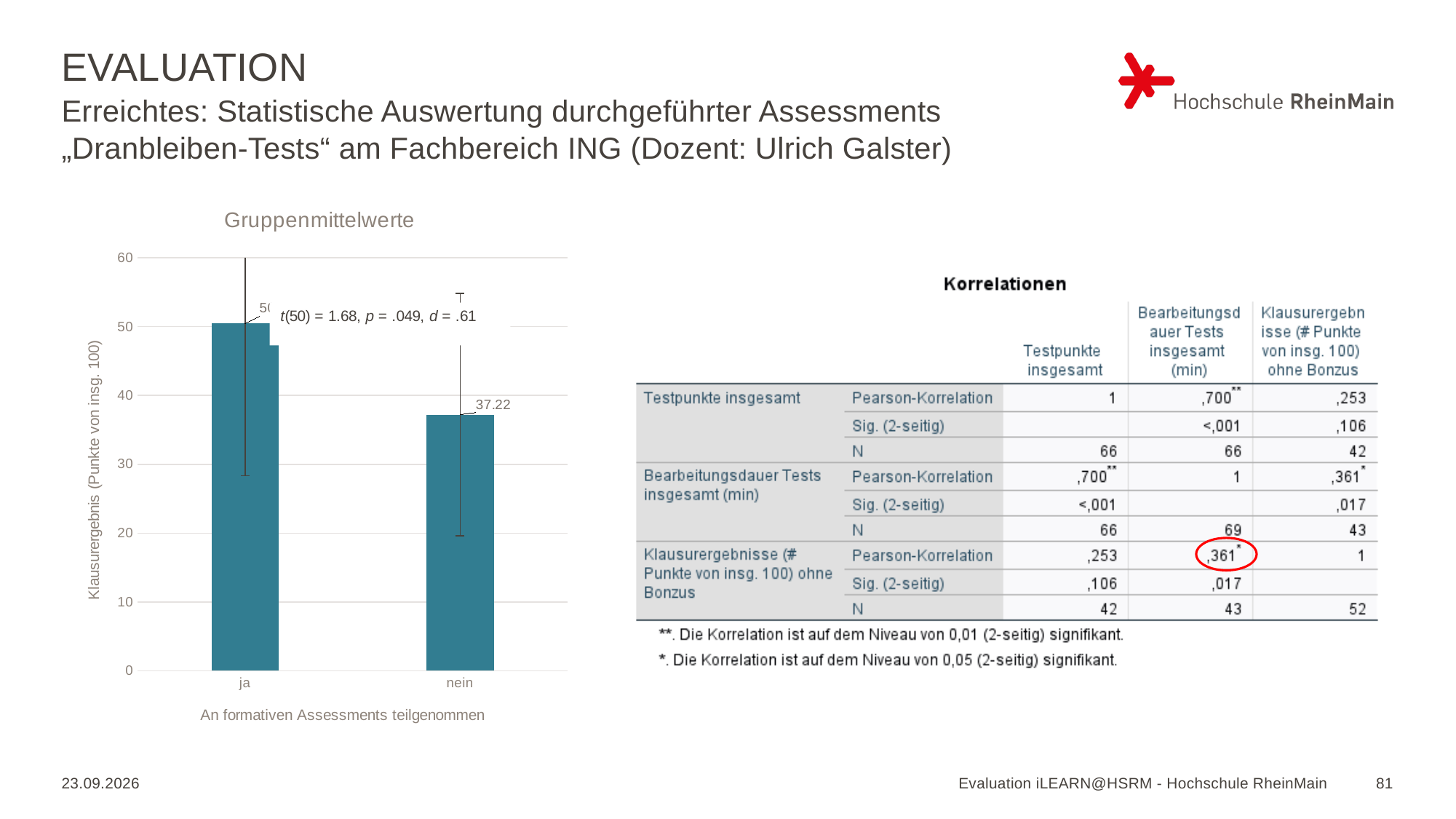
In the Gruppenmittelwerte chart, which category has the highest value? ja In the Gruppenmittelwerte chart, which is larger, the value for "ja" or the value for "nein"? ja What is the title of the bar chart on the slide? Gruppenmittelwerte In the Gruppenmittelwerte chart, is the value for "nein" greater or less than 30? greater In the Gruppenmittelwerte chart, is the value for "ja" greater or less than 40? greater What is the x-axis label of the Gruppenmittelwerte chart? An formativen Assessments teilgenommen How many categories are shown on the x axis of the Gruppenmittelwerte chart? 2 In the Gruppenmittelwerte chart, what is the value for the category "nein"? 37.22 What kind of chart is the Gruppenmittelwerte chart? bar chart In the Gruppenmittelwerte chart, do the values rise or fall from "ja" to "nein"? fall In the Gruppenmittelwerte chart, which category has the lowest value? nein In the Gruppenmittelwerte chart, is the value for "nein" greater or less than 40? less